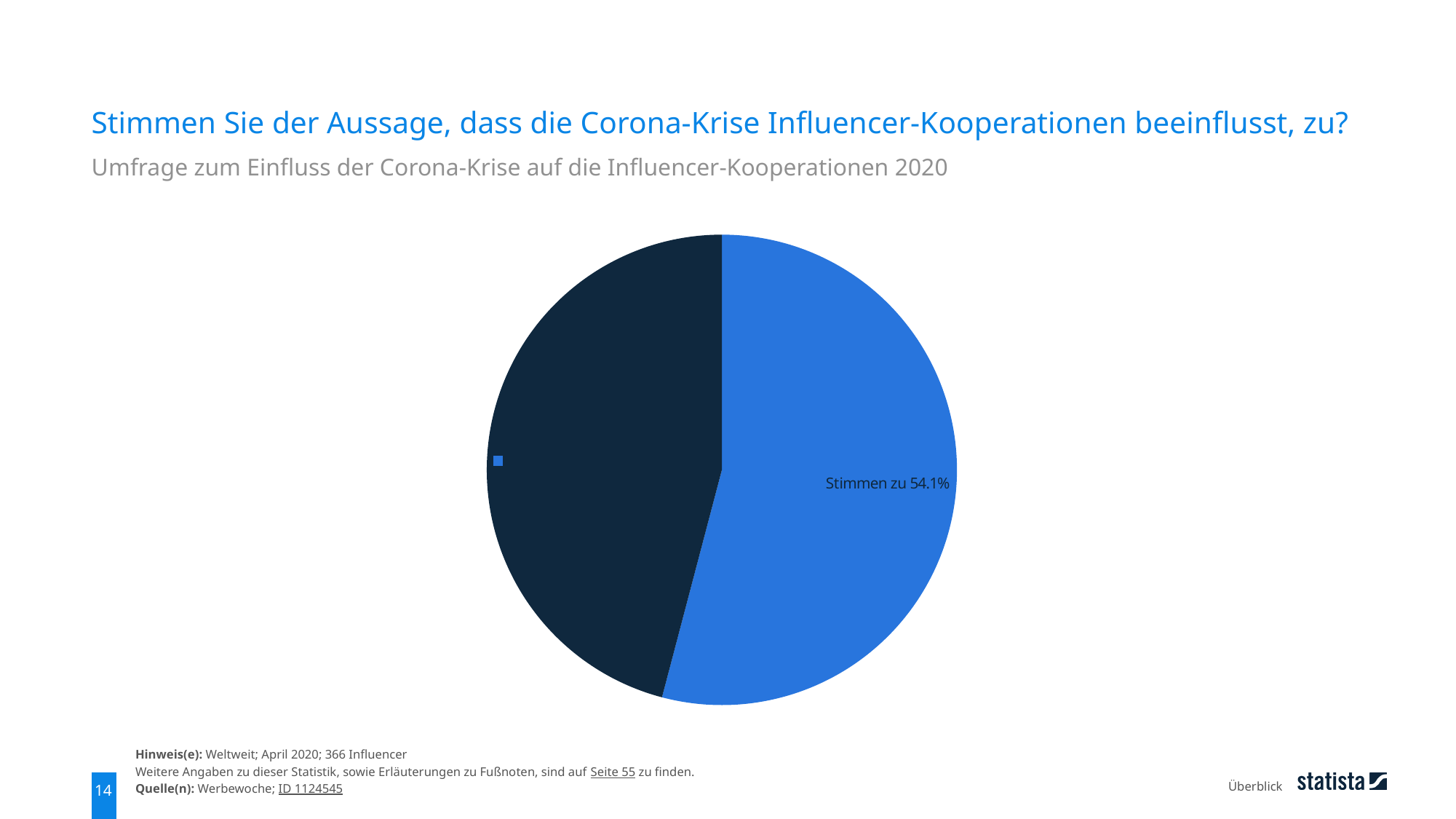
What colour is the slice labelled "Stimmen zu"? blue Which slice of the pie is the largest? Stimmen zu Is the "Stimmen zu" slice larger or smaller than the dark unlabelled slice? larger What share of the pie does the slice labelled "Stimmen zu" represent? 54.1% What is the value printed for the "Stimmen zu" slice? 54.1% What kind of chart is shown on the slide? pie chart How many slices does the pie chart have? 2 Is the share of the "Stimmen zu" slice greater or less than 50%? greater What is the title of the chart on the slide? Stimmen Sie der Aussage, dass die Corona-Krise Influencer-Kooperationen beeinflusst, zu?